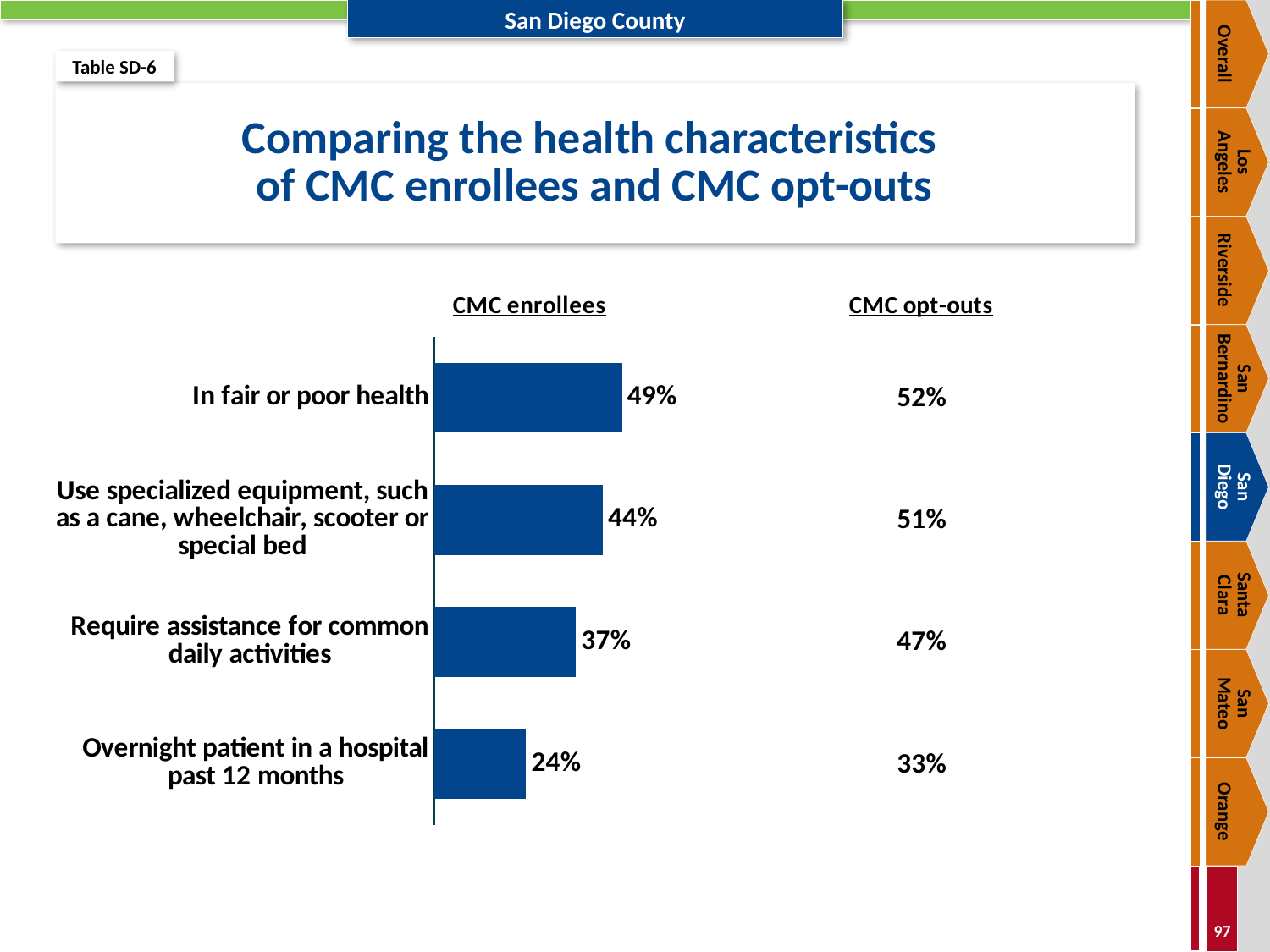
Among CMC enrollees, which is larger: the value for "Use specialized equipment, such as a cane, wheelchair, scooter or special bed" or the value for "Require assistance for common daily activities"? Use specialized equipment, such as a cane, wheelchair, scooter or special bed Which category has the lowest CMC enrollees value? Overnight patient in a hospital past 12 months How many categories are plotted in the bar chart? 4 What is the CMC enrollees value for "Overnight patient in a hospital past 12 months"? 24% What is the title of the chart? Comparing the health characteristics of CMC enrollees and CMC opt-outs What is the CMC opt-outs value printed next to "Use specialized equipment, such as a cane, wheelchair, scooter or special bed"? 51% Which category has the highest CMC enrollees value? In fair or poor health What is the difference between the CMC enrollees values for "In fair or poor health" and "Overnight patient in a hospital past 12 months"? 25% What kind of chart is shown on the slide? Bar chart What is the CMC enrollees value for "In fair or poor health"? 49% What is the CMC enrollees value for "Require assistance for common daily activities"? 37% Do the CMC enrollees bar values increase or decrease going from the top category to the bottom category? Decrease